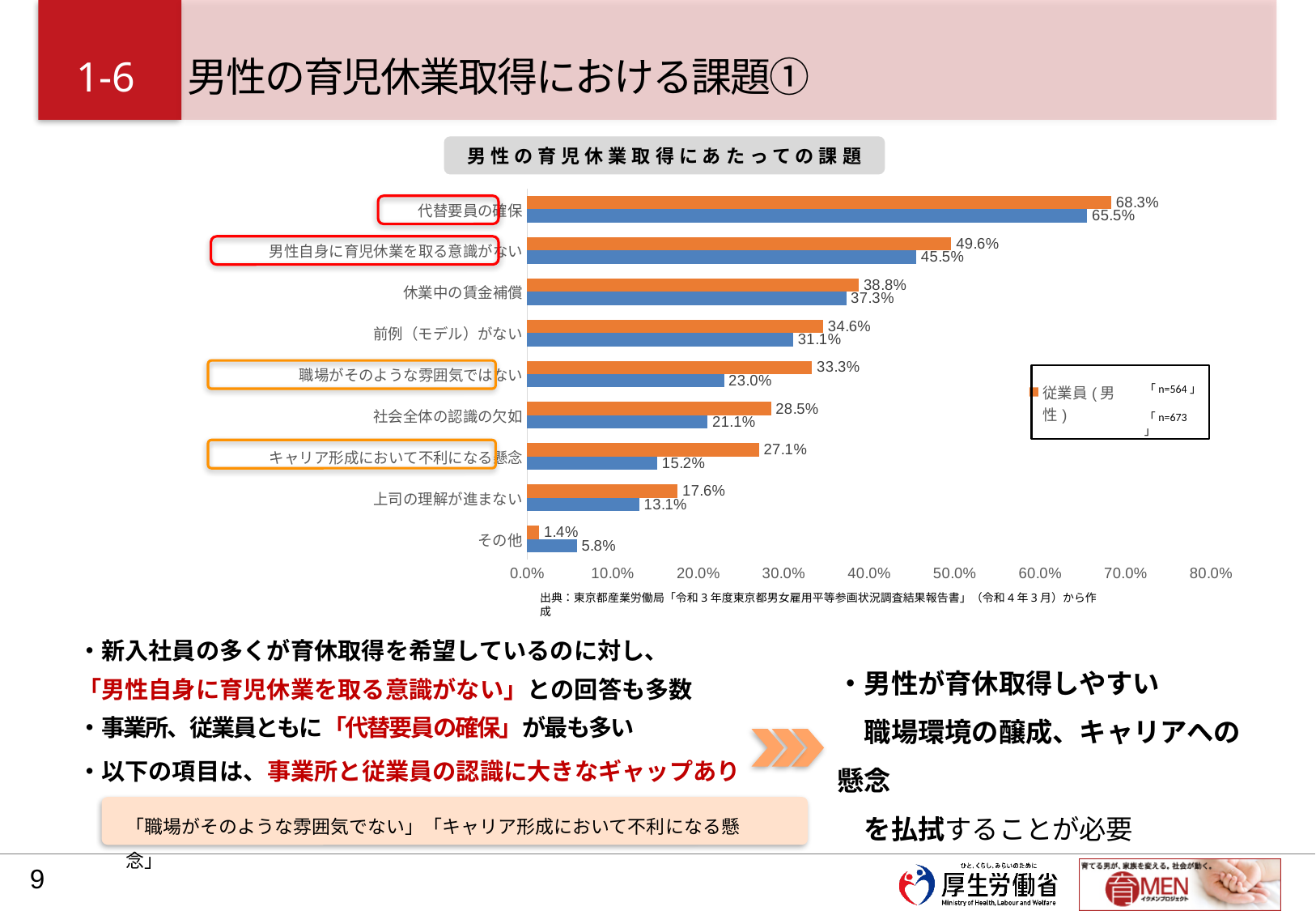
For その他, which bar is larger, the orange 従業員(男性) bar or the blue bar? the blue bar What is the value of the blue bar for 男性自身に育児休業を取る意識がない? 45.5% How many categories are plotted in the chart? 9 What is the title shown above the chart? 男性の育児休業取得にあたっての課題 What is the value of the orange 従業員(男性) bar for キャリア形成において不利になる懸念? 27.1% Is the value of the blue bar for 上司の理解が進まない greater or less than 20.0%? less What kind of chart is shown on the slide? bar chart How many series does the chart's legend list? 2 What is the value of the orange 従業員(男性) bar for 代替要員の確保? 68.3% Which category has the lowest value for the blue series? その他 What is the difference between the orange and blue bars for 職場がそのような雰囲気ではない? 10.3% Which category has the highest value for the orange 従業員(男性) series? 代替要員の確保